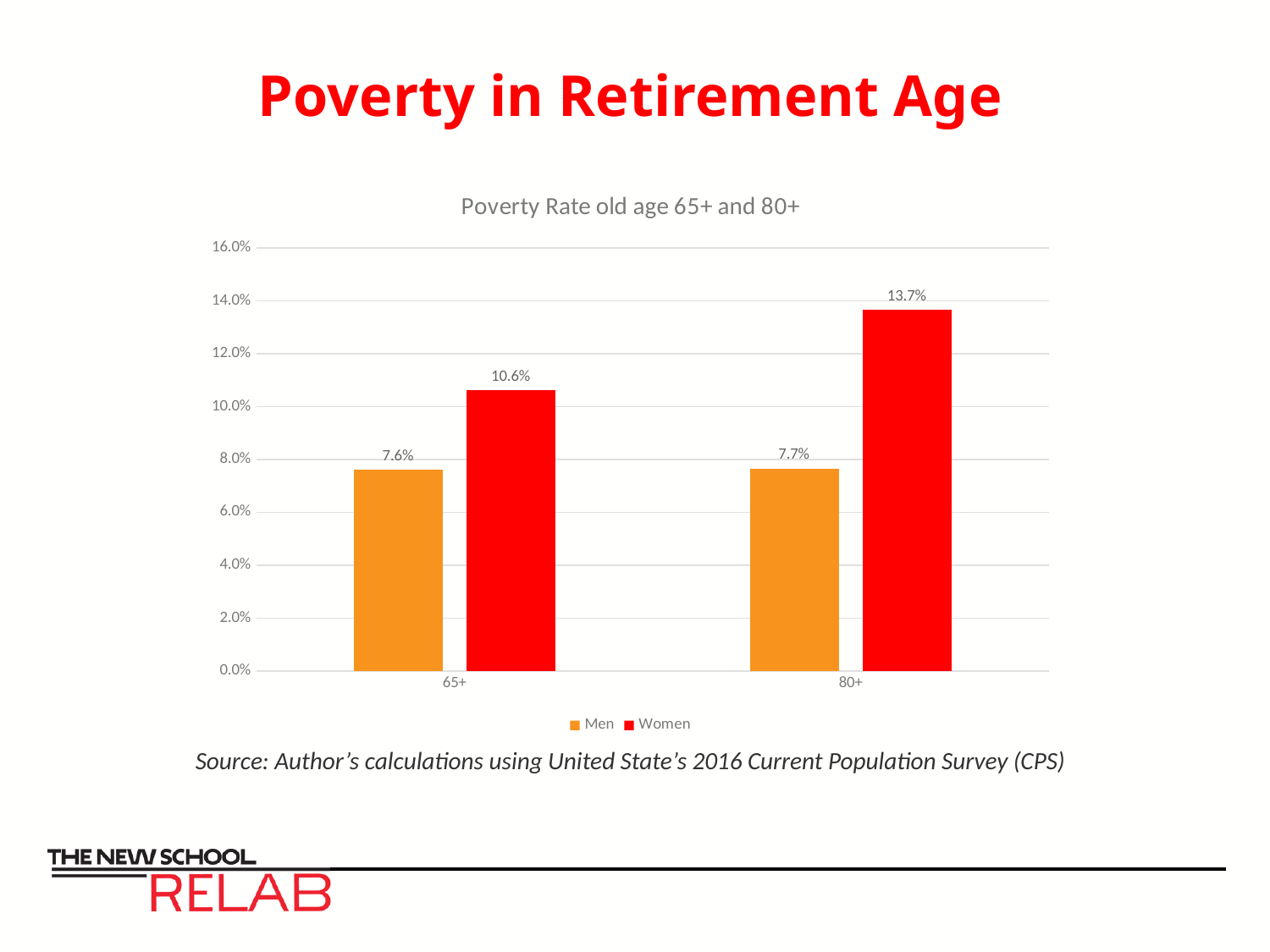
What type of chart is shown on the slide? Bar chart Which group has the lowest poverty rate on the chart? Men 65+ What is the poverty rate for men aged 80+? 7.7% Which group has the highest poverty rate on the chart? Women 80+ Which is larger, the poverty rate for women aged 65+ or for men aged 80+? Women aged 65+ What is the title of the chart? Poverty Rate old age 65+ and 80+ What is the difference between the poverty rates of women and men aged 80+? 6.0% What is the poverty rate for men aged 65+? 7.6% What is the poverty rate for women aged 65+? 10.6% How many series does the legend list? 2 What is the difference between the poverty rates of women aged 80+ and women aged 65+? 3.1% What is the poverty rate for women aged 80+? 13.7%